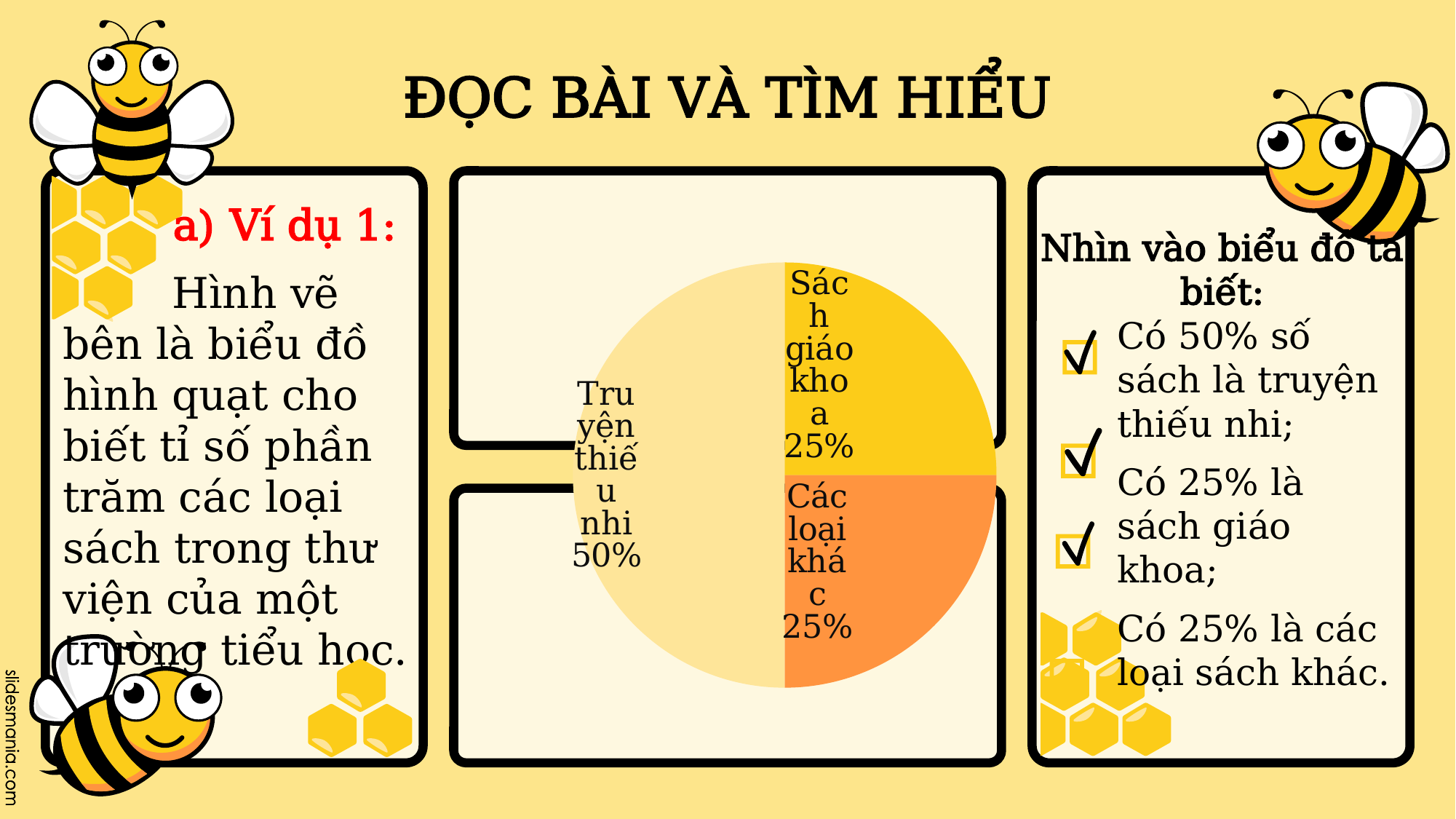
What colour is the "Các loại khác" slice of the pie chart? orange Which is larger in the pie chart, "Truyện thiếu nhi" or "Sách giáo khoa"? Truyện thiếu nhi What percentage of the pie chart is "Các loại khác"? 25% What is the difference between the "Truyện thiếu nhi" slice and the "Các loại khác" slice? 25% How many slices does the pie chart have? 3 Which slice of the pie chart is the largest? Truyện thiếu nhi What share of the pie does "Sách giáo khoa" take? 25% What percentage of the pie chart is "Truyện thiếu nhi"? 50% What kind of chart is shown on the slide? pie chart What is the total of the "Sách giáo khoa" and "Các loại khác" slices combined? 50% Do "Sách giáo khoa" and "Các loại khác" have the same share of the pie chart? Yes What percentage of the pie chart is "Sách giáo khoa"? 25%